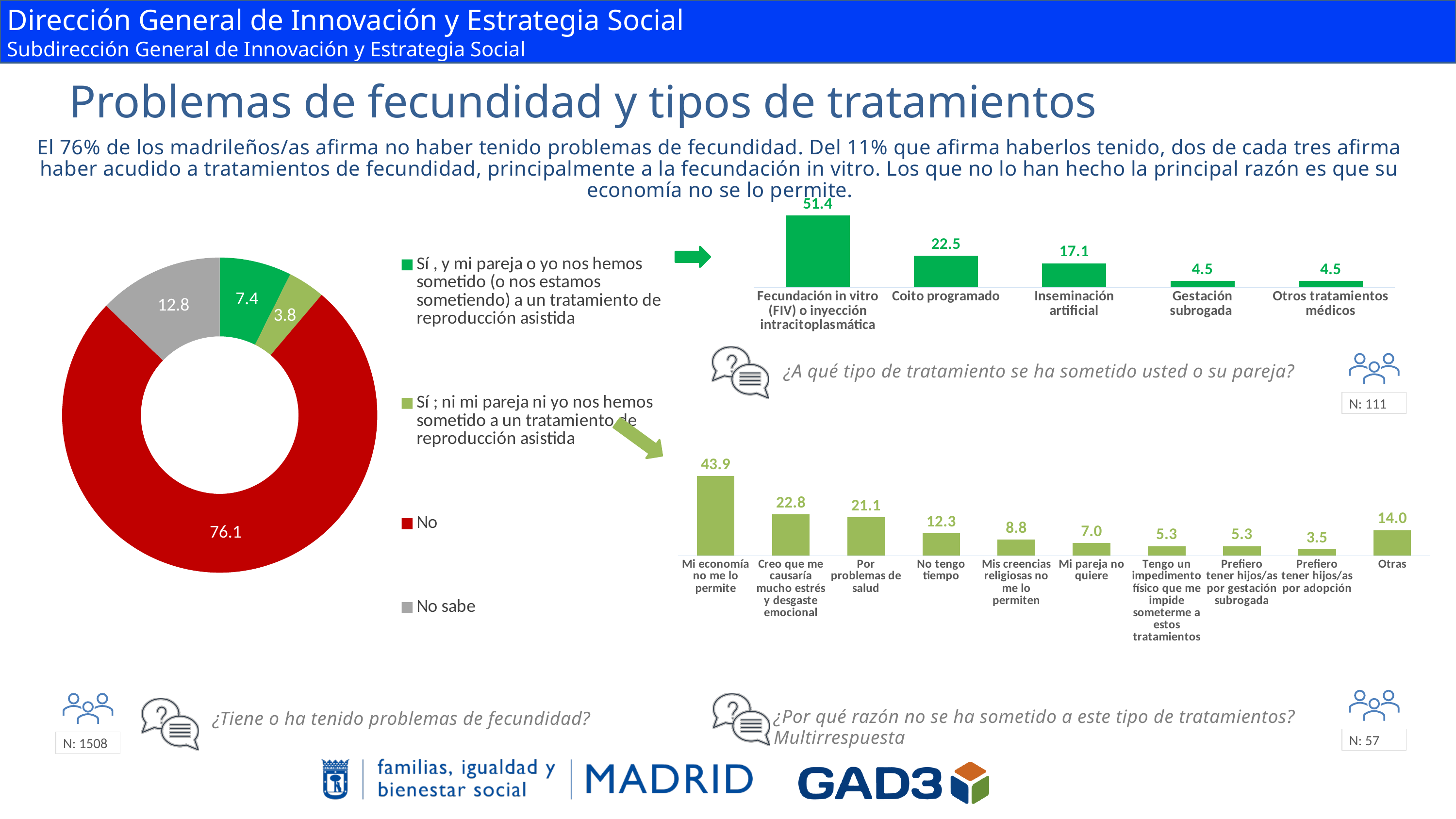
In the top-right bar chart (¿A qué tipo de tratamiento se ha sometido usted o su pareja?), how many categories are shown? 5 What type of chart is the bottom-right chart (¿Por qué razón no se ha sometido a este tipo de tratamientos?)? Bar chart In the bottom-right bar chart (¿Por qué razón no se ha sometido a este tipo de tratamientos?), which is larger: "Creo que me causaría mucho estrés y desgaste emocional" or "Por problemas de salud"? Creo que me causaría mucho estrés y desgaste emocional In the donut chart on the left, how many categories does the legend list? 4 In the bottom-right bar chart (¿Por qué razón no se ha sometido a este tipo de tratamientos?), which category has the lowest value? Prefiero tener hijos/as por adopción In the bottom-right bar chart (¿Por qué razón no se ha sometido a este tipo de tratamientos?), what is the value for "Otras"? 14.0 In the top-right bar chart (¿A qué tipo de tratamiento se ha sometido usted o su pareja?), what is the difference between "Fecundación in vitro" and "Inseminación artificial"? 34.3 In the donut chart on the left, what is the value for "No sabe"? 12.8 In the top-right bar chart (¿A qué tipo de tratamiento se ha sometido usted o su pareja?), what is the value for "Coito programado"? 22.5 In the donut chart on the left, what is the difference between the two "Sí" categories (7.4 and 3.8)? 3.6 In the top-right bar chart (¿A qué tipo de tratamiento se ha sometido usted o su pareja?), which category has the highest value? Fecundación in vitro (FIV) o inyección intracitoplasmática In the donut chart on the left, what is the value for "No"? 76.1